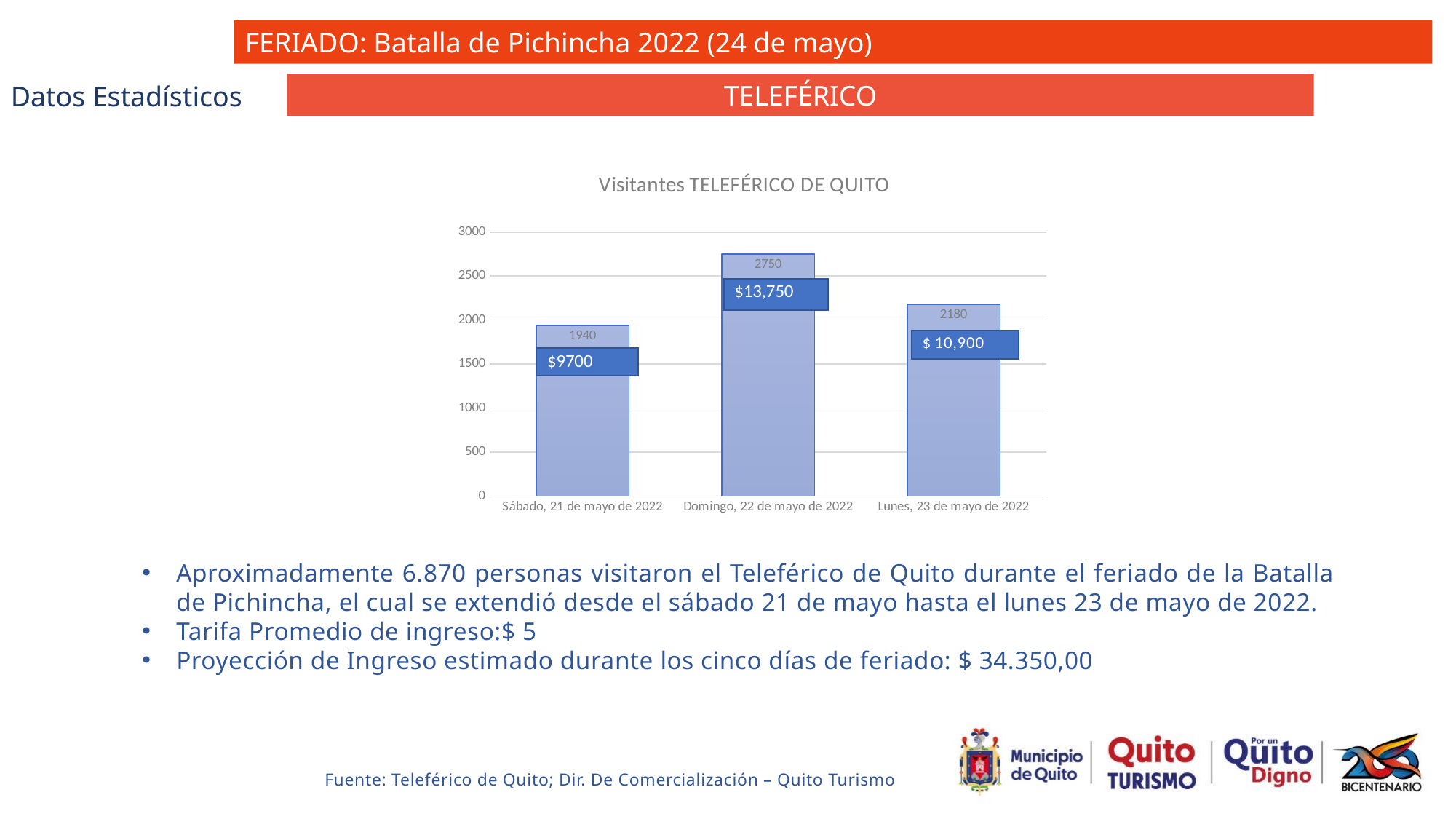
What is the number of visitors shown for Sábado, 21 de mayo de 2022? 1940 Which day had more visitors, Lunes, 23 de mayo de 2022 or Sábado, 21 de mayo de 2022? Lunes, 23 de mayo de 2022 What is the difference in visitors between Domingo, 22 de mayo de 2022 and Sábado, 21 de mayo de 2022? 810 Is the value for Lunes, 23 de mayo de 2022 greater or less than 2000? greater Which day has the highest number of visitors? Domingo, 22 de mayo de 2022 How many days (categories) are shown in the chart? 3 What is the number of visitors shown for Lunes, 23 de mayo de 2022? 2180 What is the number of visitors shown for Domingo, 22 de mayo de 2022? 2750 What kind of chart is shown on the slide? Bar chart Which day has the lowest number of visitors? Sábado, 21 de mayo de 2022 What revenue amount is shown in the label on the bar for Domingo, 22 de mayo de 2022? $13,750 What is the title of the chart? Visitantes TELEFÉRICO DE QUITO